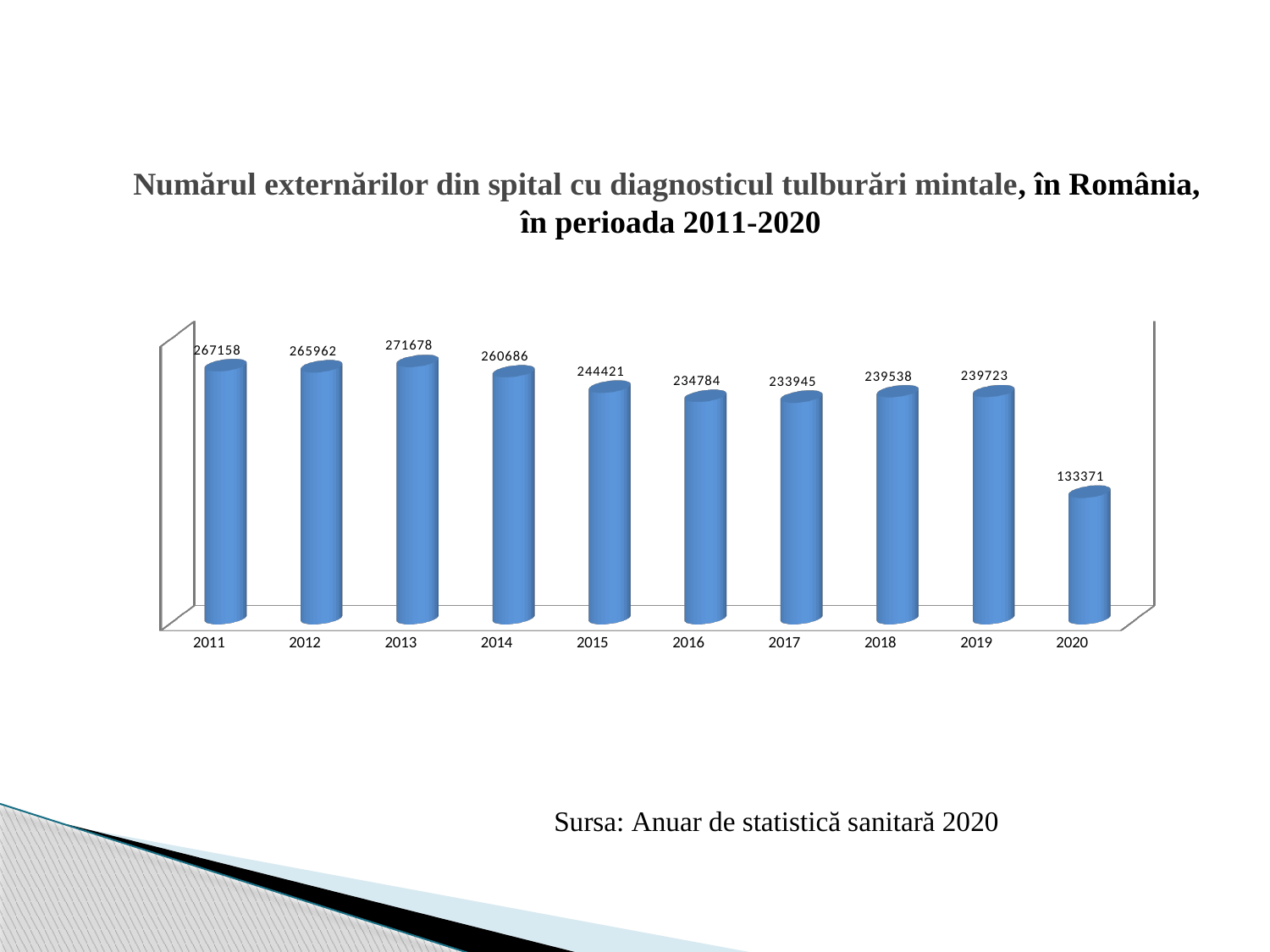
What is the value for 2015? 244421 Which is larger, the value for 2011 or the value for 2016? 2011 Which year has the highest value? 2013 What source is cited below the chart? Anuar de statistică sanitară 2020 What is the value for 2011? 267158 Do the values generally rise or fall from 2011 to 2020? fall How many years are shown on the x axis? 10 What is the difference between the values for 2013 and 2014? 10992 What is the difference between the values for 2019 and 2020? 106352 What kind of chart is this? bar chart What is the value for 2020? 133371 Which year has the lowest value? 2020